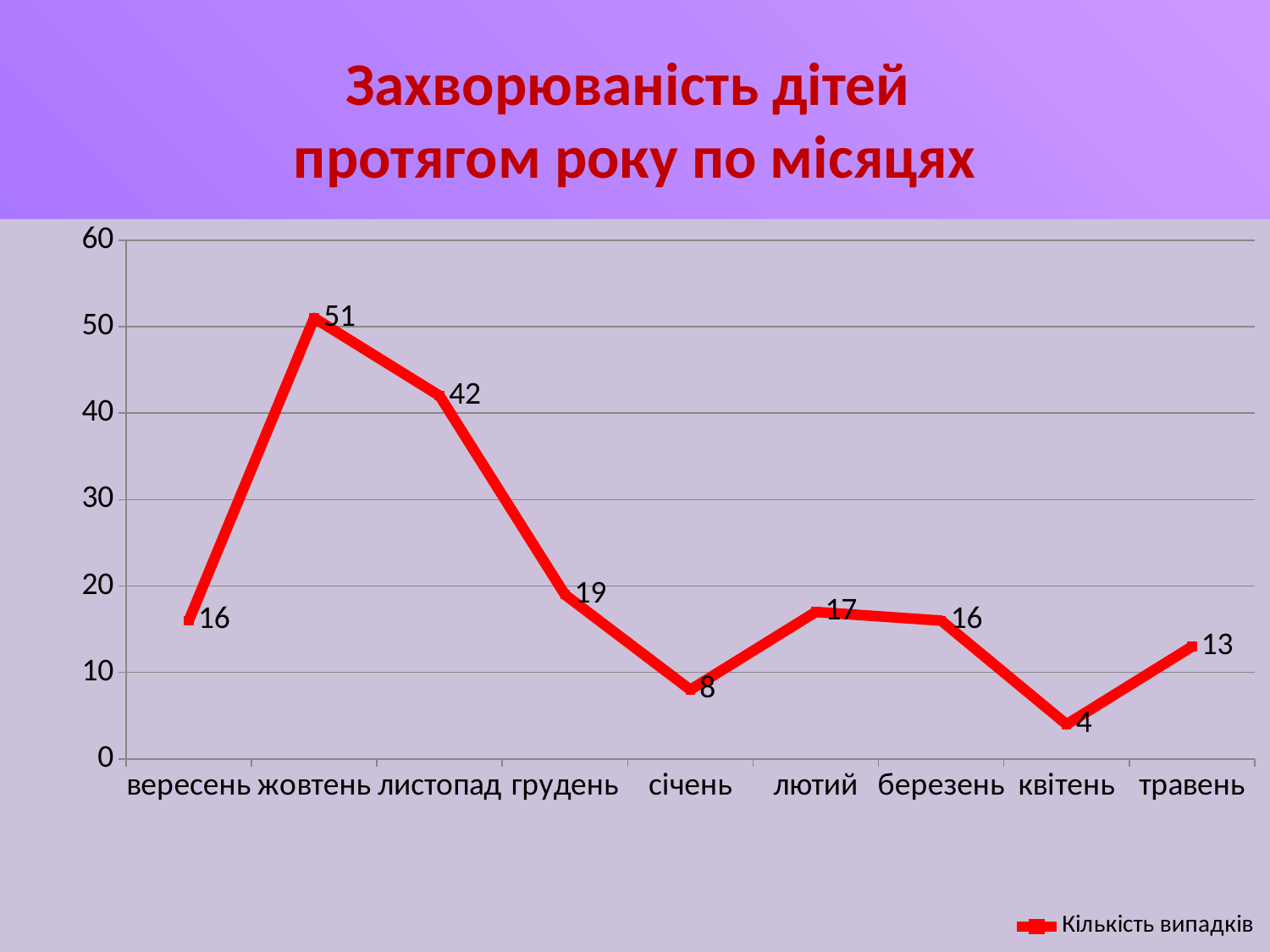
What is the legend entry for the plotted series? Кількість випадків What is the value for травень? 13 What is the value for жовтень? 51 Is the value for грудень greater or less than 20? less Which is larger, the value for лютий or the value for березень? лютий Which month has the lowest value? квітень How many months are plotted on the x axis? 9 Which month has the highest value? жовтень How many series does the legend list? 1 What type of chart is shown on the slide? line chart What is the difference between the values for жовтень and листопад? 9 What is the value for січень? 8